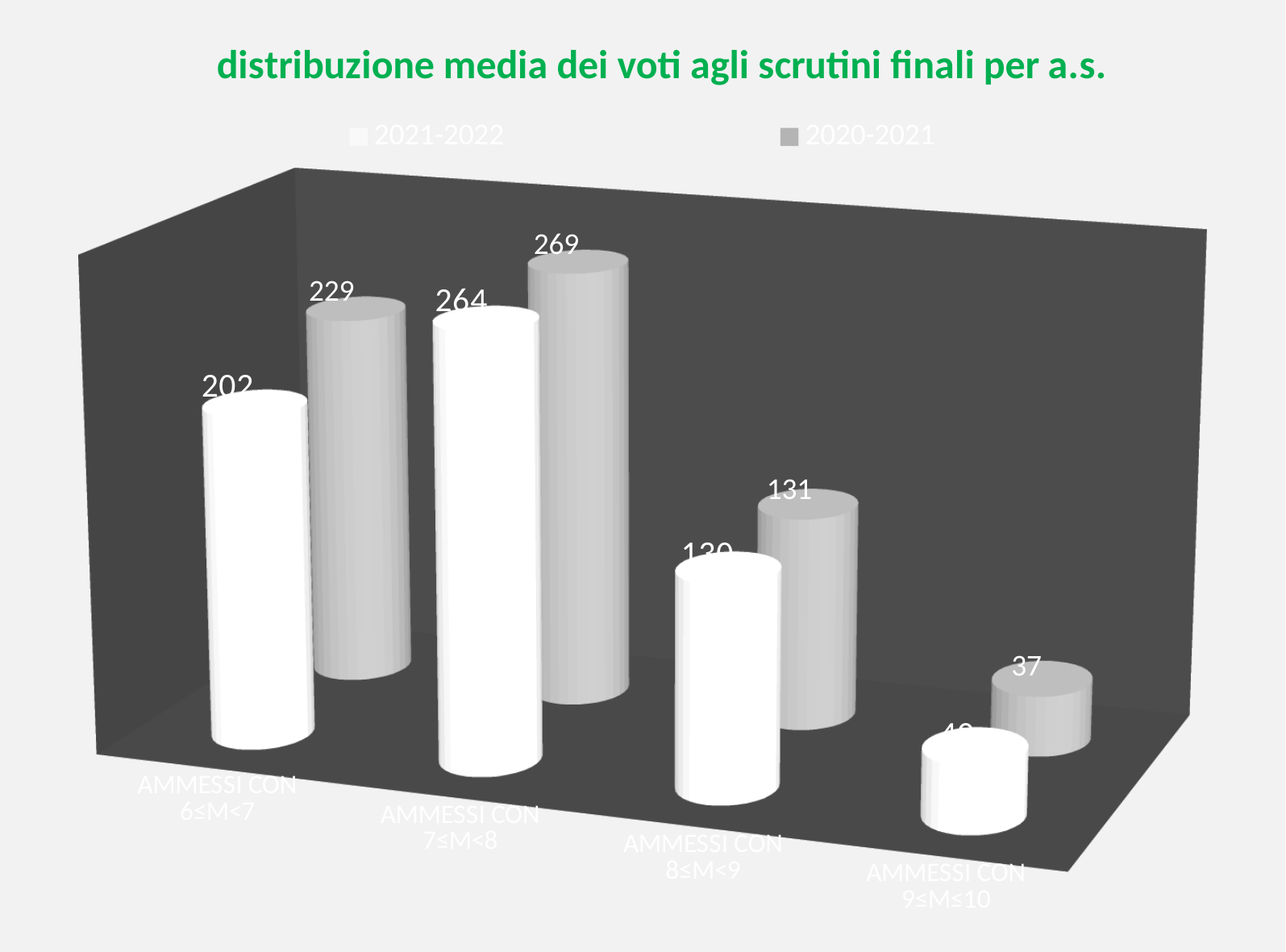
What is the value for AMMESSI CON 8≤M<9 in the 2020-2021 series? 131 How many series does the legend list? 2 What is the difference between the 2020-2021 and 2021-2022 values for AMMESSI CON 6≤M<7? 27 Which category has the lowest value in the 2020-2021 series? AMMESSI CON 9≤M≤10 What is the value for AMMESSI CON 6≤M<7 in the 2020-2021 series? 229 Which category has the highest value in the 2020-2021 series? AMMESSI CON 7≤M<8 What is the value for AMMESSI CON 7≤M<8 in the 2021-2022 series? 264 What is the value for AMMESSI CON 6≤M<7 in the 2021-2022 series? 202 What kind of chart is shown on the slide? bar chart What is the value for AMMESSI CON 7≤M<8 in the 2020-2021 series? 269 What is the value for AMMESSI CON 9≤M≤10 in the 2020-2021 series? 37 How many categories are shown on the x axis? 4